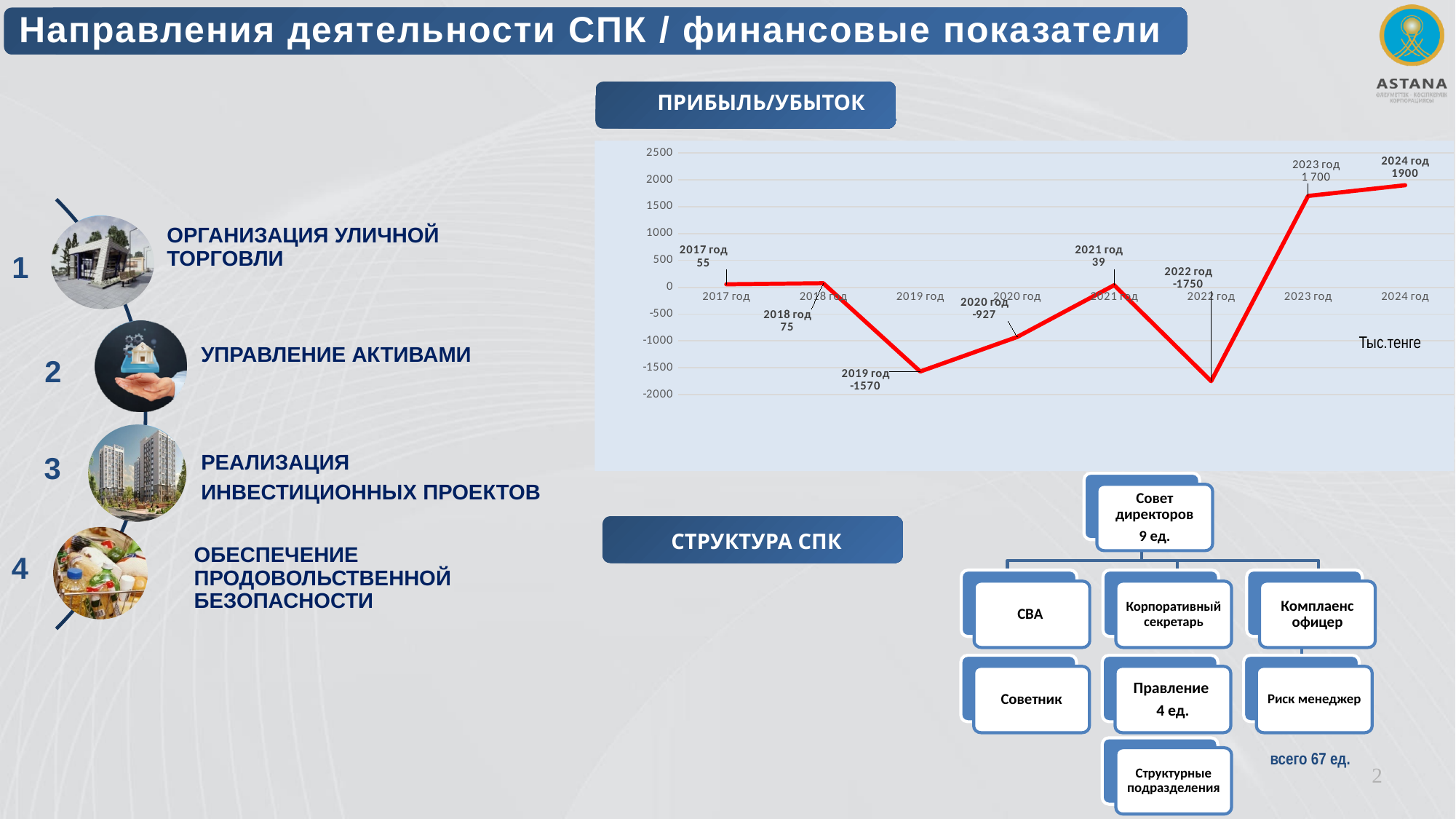
In the ПРИБЫЛЬ/УБЫТОК chart, which is larger, the value for 2018 год or the value for 2021 год? 2018 год In the ПРИБЫЛЬ/УБЫТОК chart, what is the value for 2019 год? -1570 In the ПРИБЫЛЬ/УБЫТОК chart, what is the value for 2023 год? 1 700 What type of chart is shown under the heading ПРИБЫЛЬ/УБЫТОК? line chart In the ПРИБЫЛЬ/УБЫТОК chart, what is the difference between the values for 2024 год and 2023 год? 200 In the ПРИБЫЛЬ/УБЫТОК chart, which year has the highest value? 2024 год In the ПРИБЫЛЬ/УБЫТОК chart, which year has the lowest value? 2022 год In the ПРИБЫЛЬ/УБЫТОК chart, what is the value for 2022 год? -1750 In the ПРИБЫЛЬ/УБЫТОК chart, what is the value for 2017 год? 55 What unit is indicated on the ПРИБЫЛЬ/УБЫТОК chart? Тыс.тенге In the ПРИБЫЛЬ/УБЫТОК chart, how many years are plotted? 8 In the ПРИБЫЛЬ/УБЫТОК chart, does the value rise or fall from 2022 год to 2023 год? rise